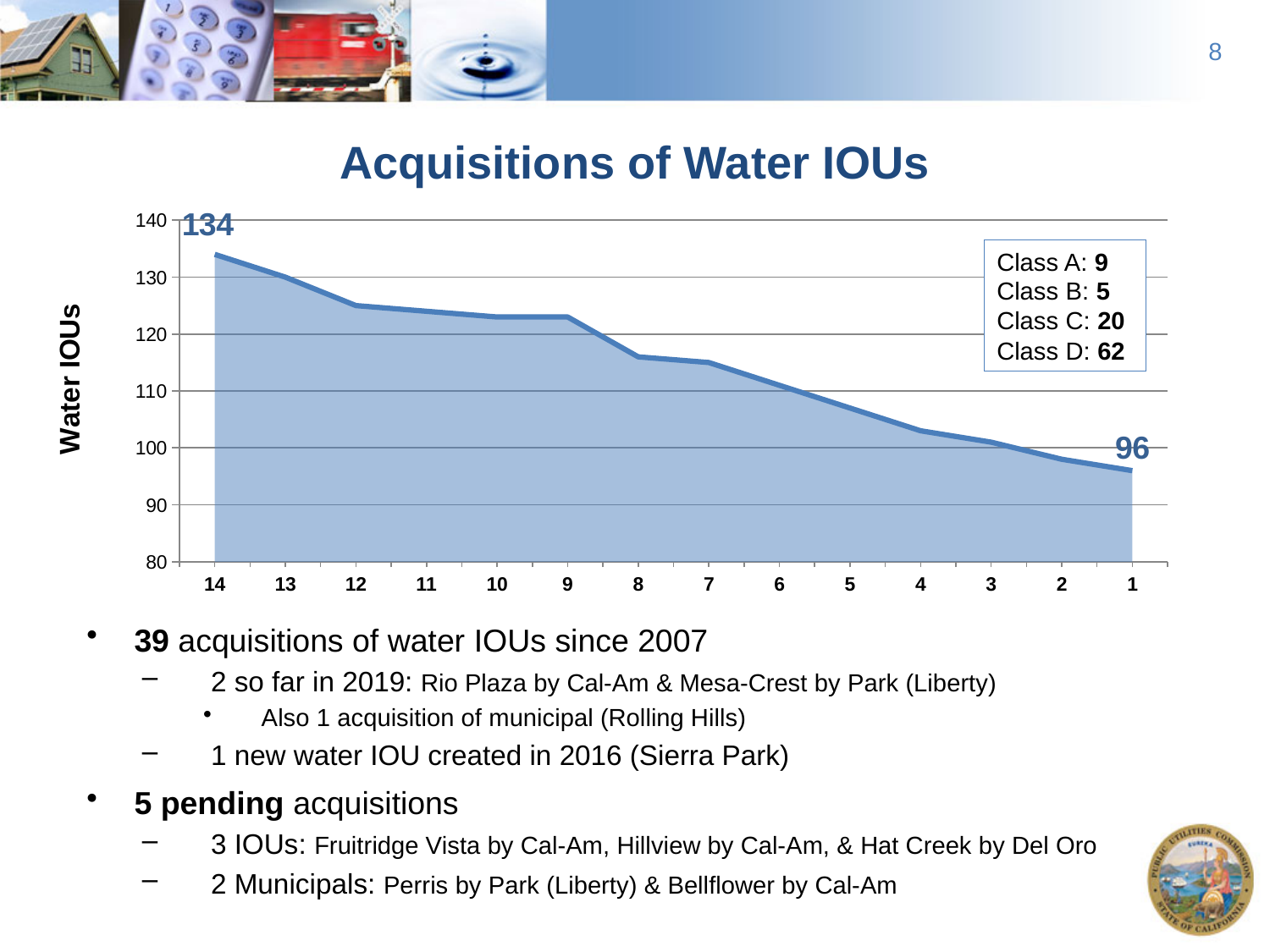
What is the value of Water IOUs at x-axis point 14? 134 What kind of chart is shown on the slide? Area chart What is the title of the chart? Acquisitions of Water IOUs What is the value of Water IOUs at x-axis point 1? 96 What is the difference between the Water IOUs value at point 14 and at point 1? 38 Do the Water IOUs values rise or fall moving from left to right along the x axis? Fall Is the Water IOUs value at point 4 greater or less than 110? less Which x-axis point has the lowest Water IOUs value? 1 How many points are plotted along the x axis? 14 Is the Water IOUs value at point 2 greater or less than 100? less Is the Water IOUs value at point 12 greater or less than 120? greater Which x-axis point has the highest Water IOUs value? 14